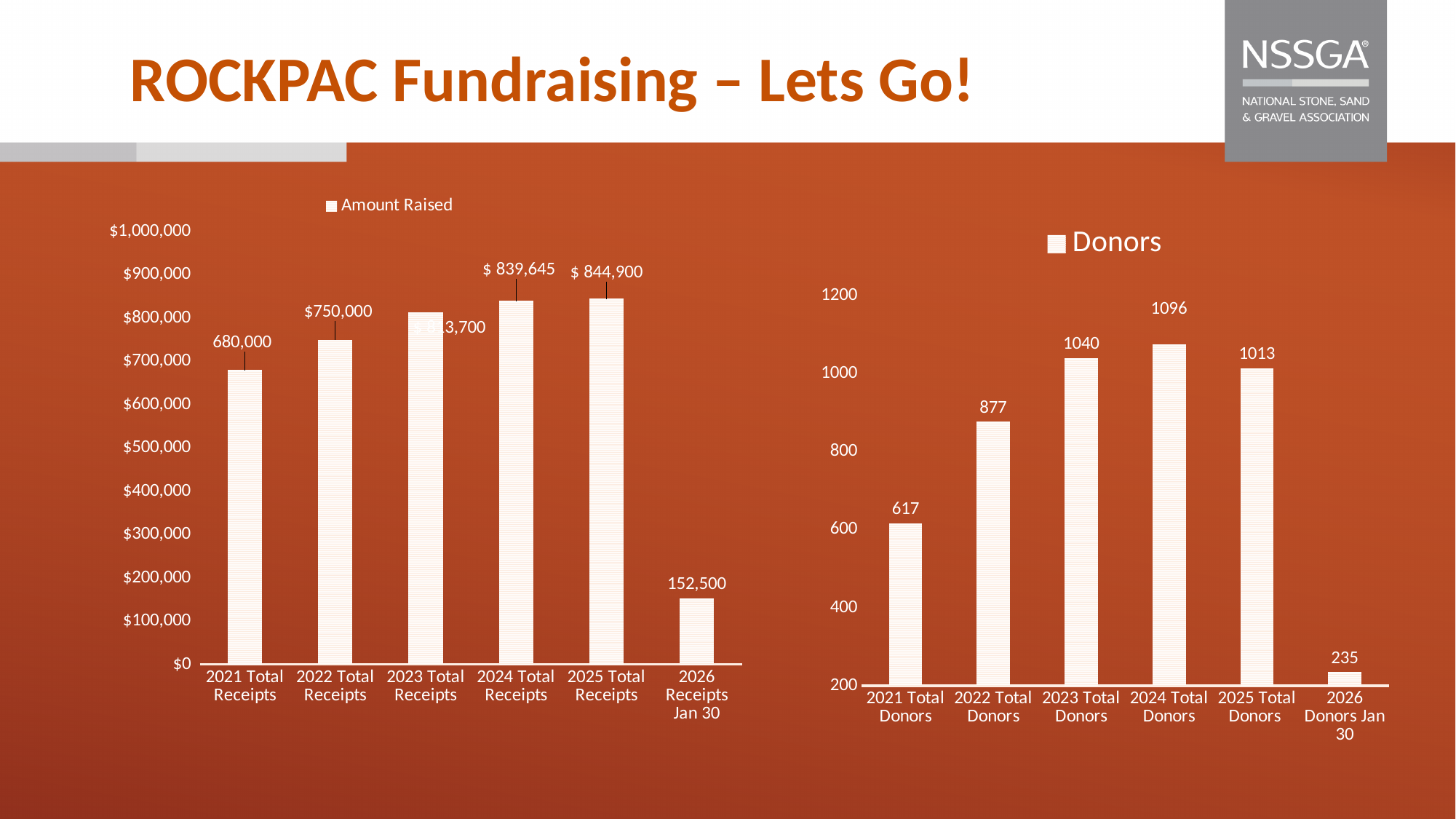
In the Donors chart, what is the value for 2024 Total Donors? 1096 In the Donors chart, which category has the highest value? 2024 Total Donors In the Amount Raised chart, which category has the lowest value? 2026 Receipts Jan 30 What kind of chart is the Amount Raised chart on the left? bar chart In the Amount Raised chart, what is the value for 2022 Total Receipts? $750,000 In the Amount Raised chart, what is the difference between 2025 Total Receipts and 2024 Total Receipts? $5,255 In the Donors chart, what is the difference between 2023 Total Donors and 2022 Total Donors? 163 What is the legend entry shown on the left chart? Amount Raised How many categories are shown in the Amount Raised chart? 6 In the Donors chart, do the values rise or fall from 2021 Total Donors to 2024 Total Donors? rise In the Amount Raised chart, what is the value for 2026 Receipts Jan 30? 152,500 In the Donors chart, which is larger: 2023 Total Donors or 2025 Total Donors? 2023 Total Donors